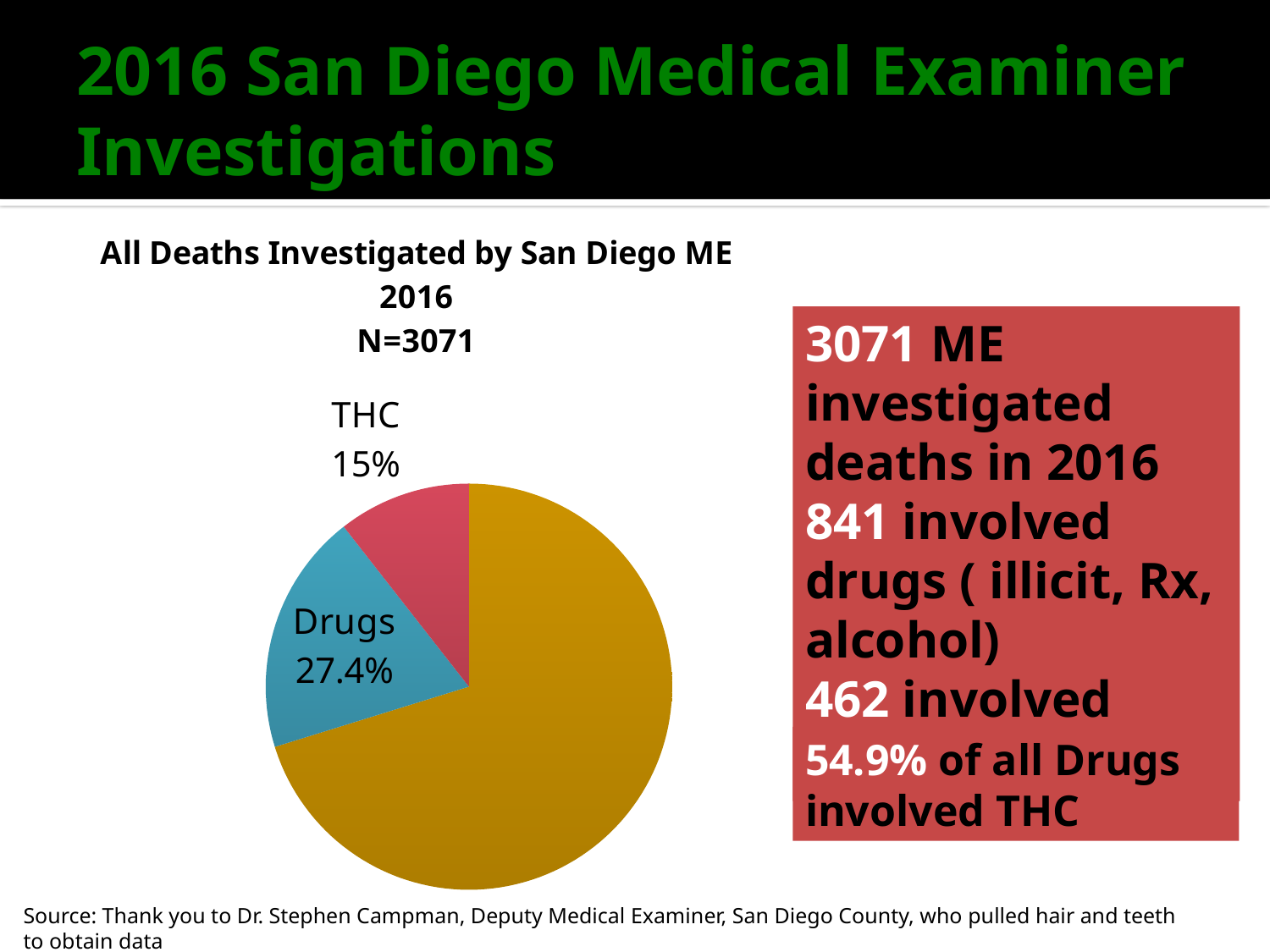
What kind of chart is shown on the slide? pie chart Which slice is larger, Drugs or THC? Drugs Which labeled slice is the smallest in the pie chart? THC What is the difference in percentage points between the Drugs slice and the THC slice? 12.4 What share of all deaths investigated does the THC slice represent? 15% What percentage of the pie is the THC slice? 15% What is the title of the pie chart? All Deaths Investigated by San Diego ME 2016 N=3071 How many slices does the pie chart have? 3 What is the N value stated in the chart title? 3071 What percentage of the pie is the Drugs slice? 27.4%